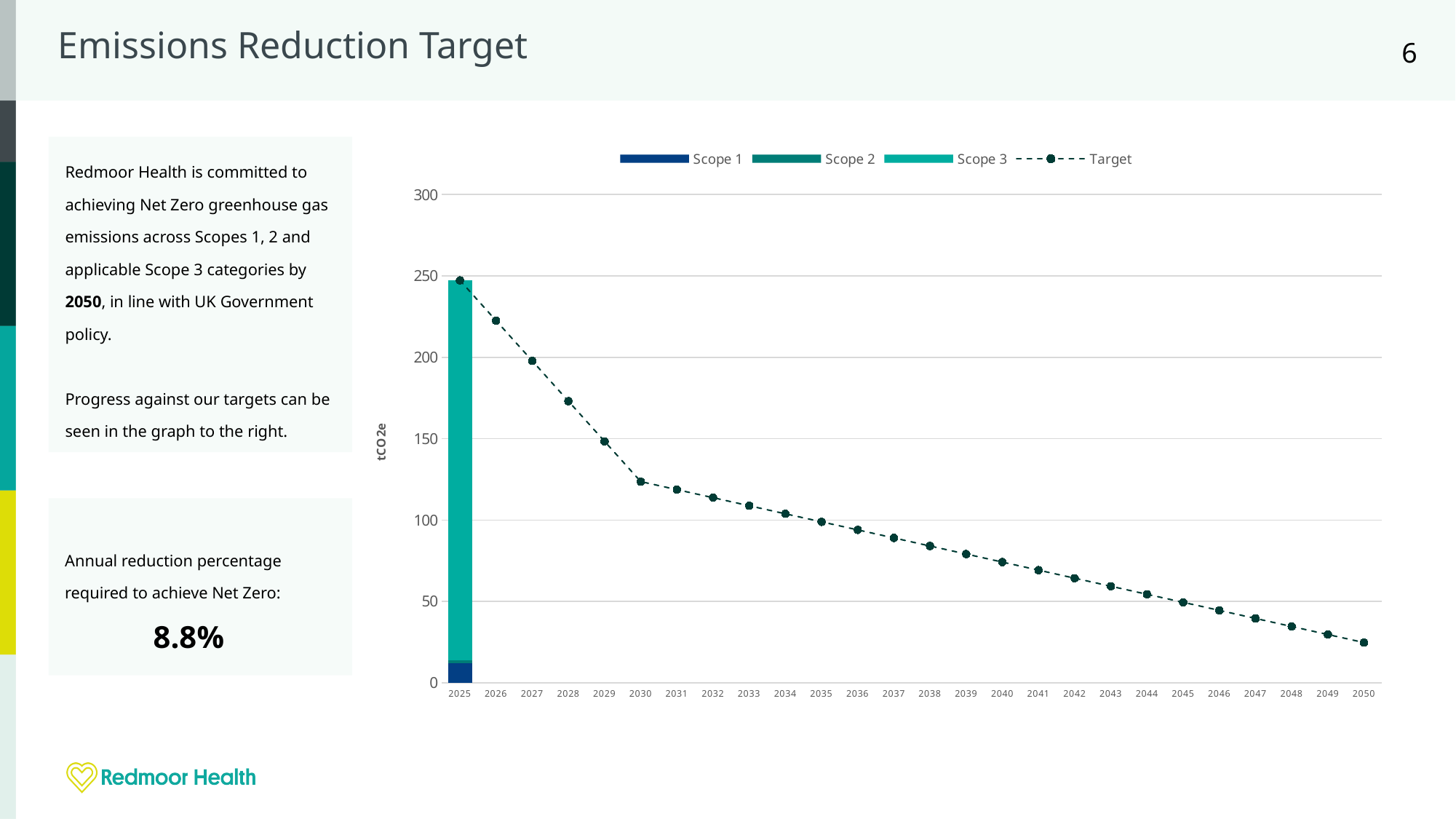
Does the Target line rise or fall from 2025 to 2050? Fall Is the Target value for 2030 greater or less than 100? greater Is the Target value for 2025 greater or less than 200? greater In which year is the Target value lowest? 2050 In which year is the Target value highest? 2025 What kind of chart is shown on the slide? A combined bar and line chart (stacked bars with a dashed Target line) What is the label on the vertical axis of the chart? tCO2e How many series does the chart legend list? 4 How many years are shown along the x axis of the chart? 26 Is the Target value for 2040 greater or less than 100? less Which is larger, the Target value for 2030 or for 2040? 2030